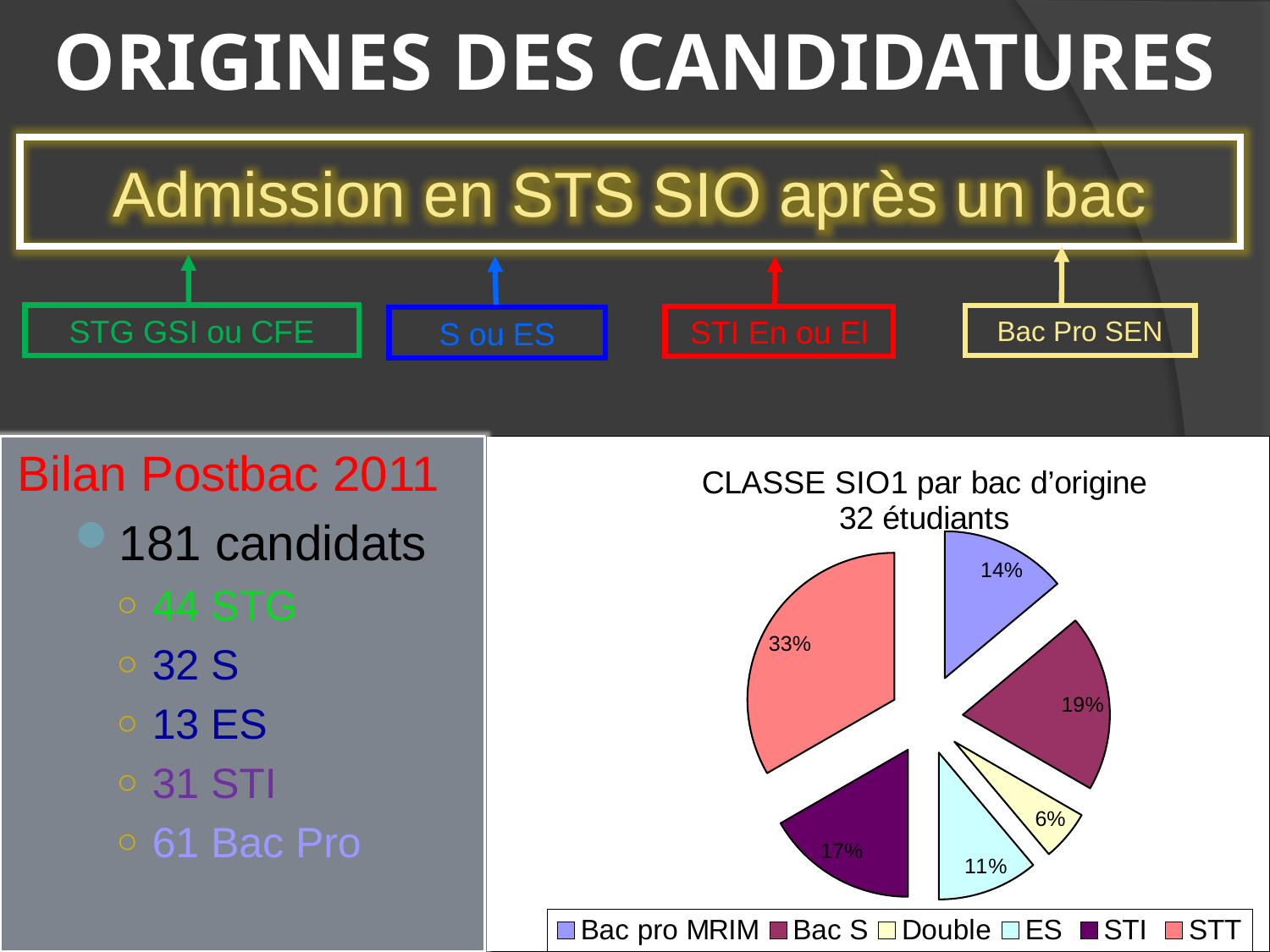
What share of the pie does Bac S represent? 19% Which category has the largest slice of the pie? STT Which category has the smallest slice of the pie? Double What share of the pie does Double represent? 6% What share of the pie does STT represent? 33% Which slice is larger, Bac S or ES? Bac S What is the title of the chart? CLASSE SIO1 par bac d'origine 32 étudiants How many slices does the pie chart have? 6 What kind of chart is shown on the slide? pie chart What is the difference in percentage points between the STT slice and the STI slice? 16%